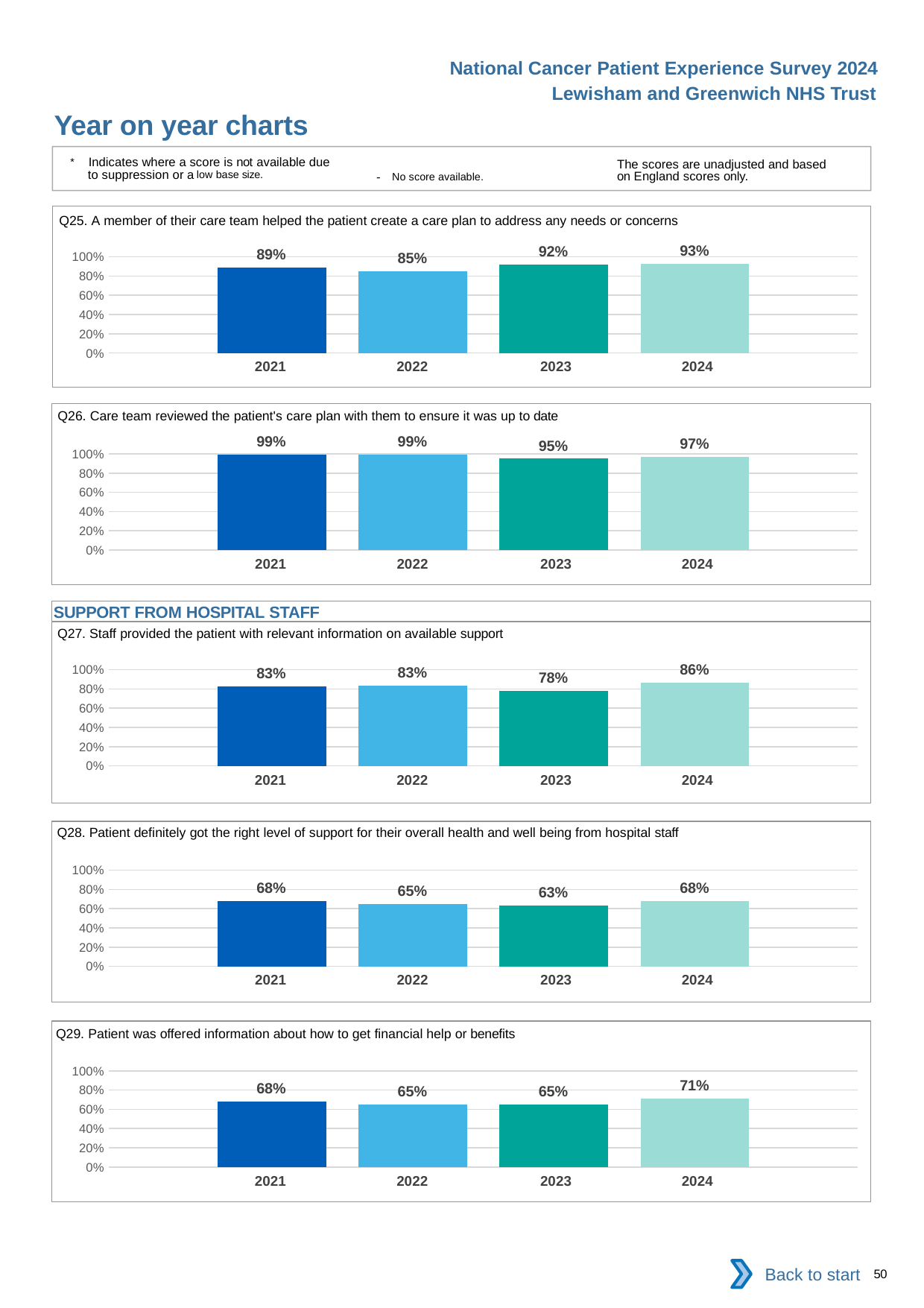
In the Q26 chart (care team reviewed the patient's care plan), is the value for 2024 greater or less than 80%? greater In the Q27 chart (staff provided relevant information on available support), what is the value for 2023? 78% In the Q28 chart (right level of support for overall health and well being), which is larger, the value for 2022 or the value for 2023? 2022 In the Q28 chart (right level of support for overall health and well being), how many years are plotted? 4 In the Q25 chart (care team helped the patient create a care plan), which year has the lowest value? 2022 In the Q25 chart (care team helped the patient create a care plan), what is the value for 2024? 93% In the Q26 chart (care team reviewed the patient's care plan), what is the value for 2023? 95% In the Q29 chart (information about financial help or benefits), what is the value for 2024? 71% In the Q29 chart (information about financial help or benefits), what is the difference between the 2024 and 2021 values? 3 percentage points In the Q26 chart (care team reviewed the patient's care plan), what is the difference between the 2021 and 2023 values? 4 percentage points In the Q27 chart (staff provided relevant information on available support), which year has the highest value? 2024 What kind of chart is the Q29 chart (information about financial help or benefits)? Bar chart